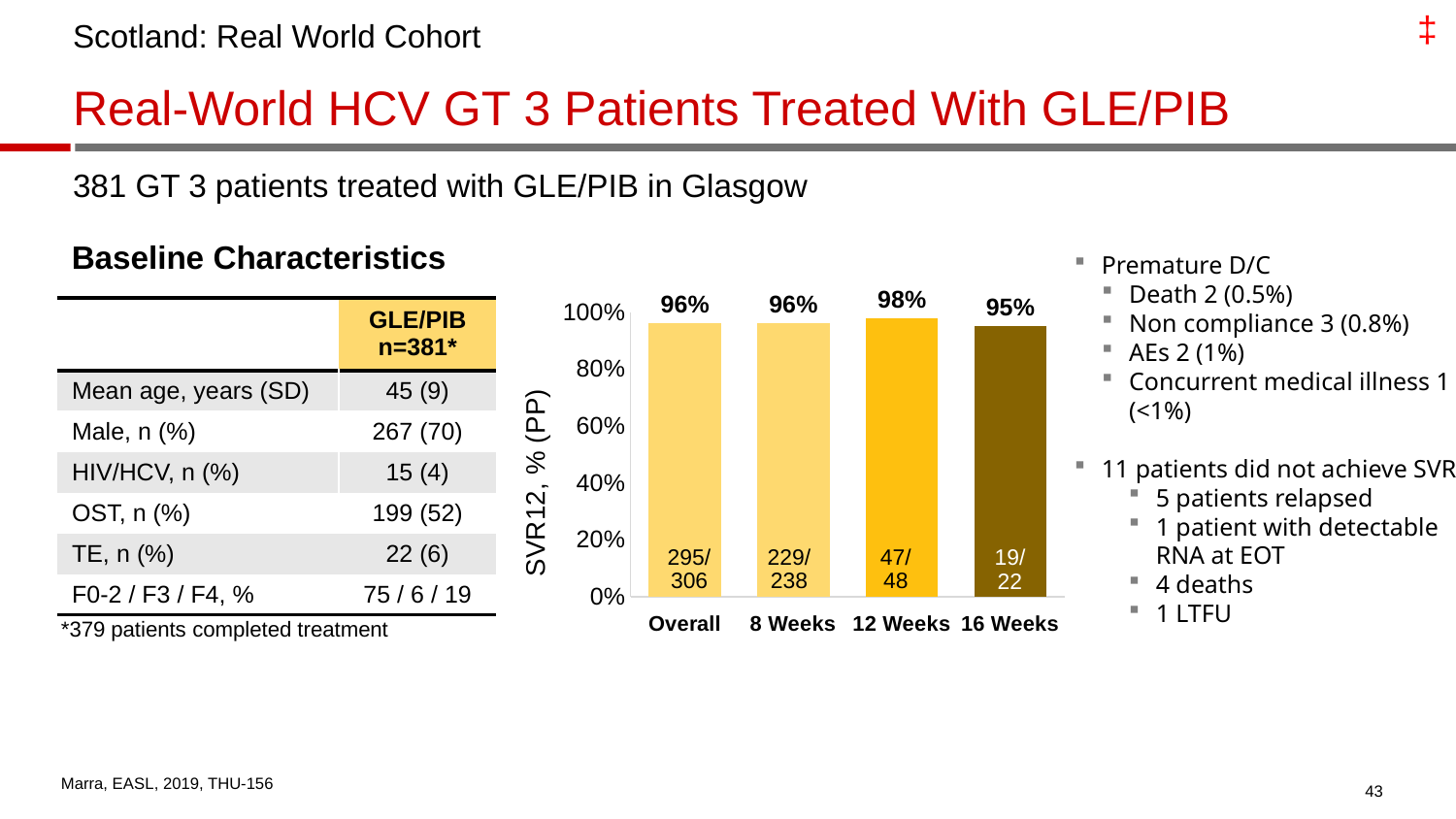
What type of chart is used to show the SVR12 rates? Bar chart What is the SVR12 rate for patients treated for 8 Weeks? 96% Which treatment duration category has the highest SVR12 rate? 12 Weeks What fraction (n/N) is shown inside the 12 Weeks bar? 47/48 What is the label of the y axis of the chart? SVR12, % (PP) Which has a higher SVR12 rate, 12 Weeks or 16 Weeks? 12 Weeks What is the SVR12 rate for patients treated for 12 Weeks? 98% What is the difference in SVR12 rate between the 12 Weeks and 16 Weeks groups? 3% How many categories are shown on the x axis of the chart? 4 Which category has the lowest SVR12 rate? 16 Weeks What is the SVR12 rate for the Overall group? 96% What is the SVR12 rate for patients treated for 16 Weeks? 95%